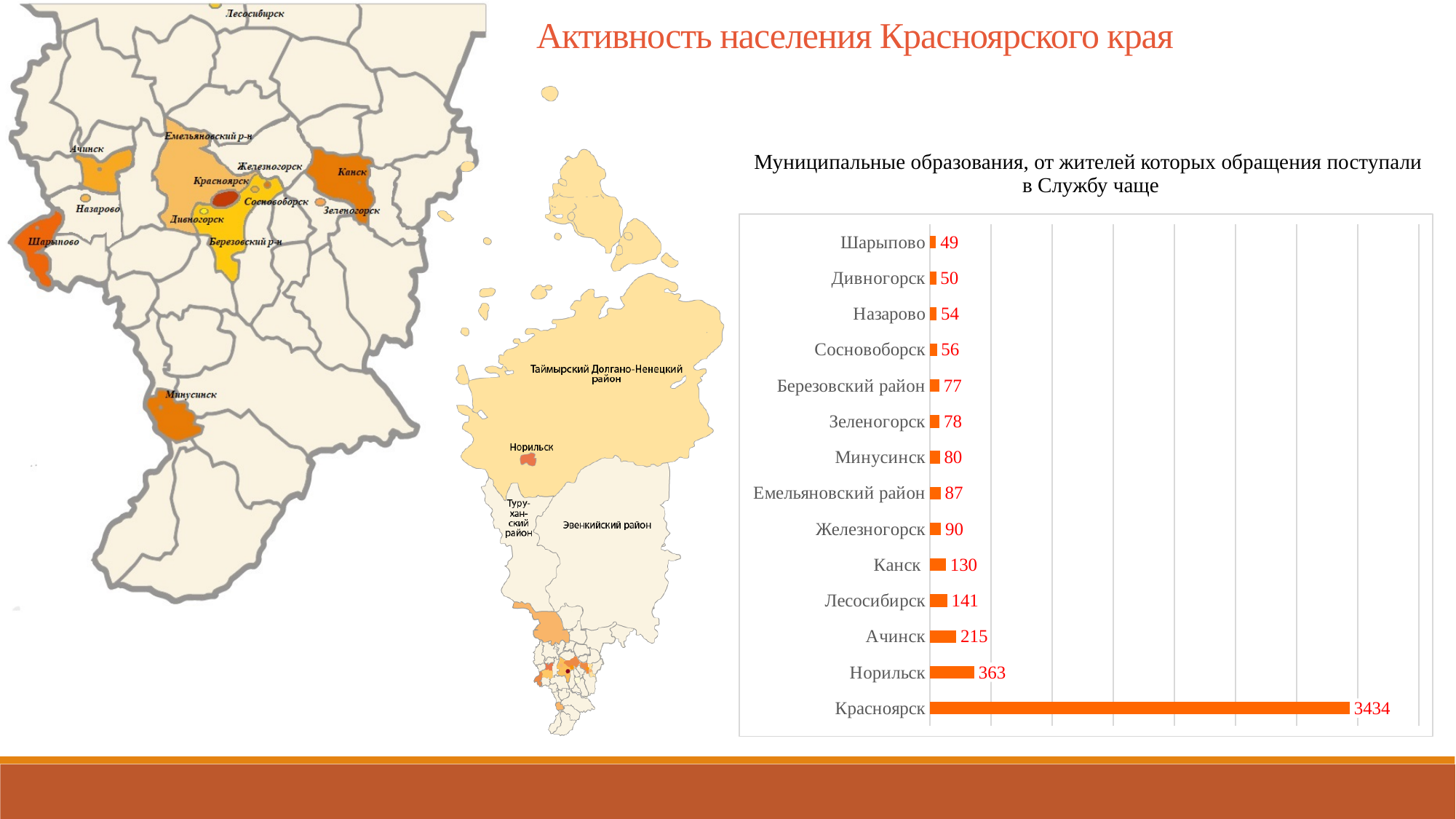
What is the title of the chart? Муниципальные образования, от жителей которых обращения поступали в Службу чаще What is the difference between the values for Красноярск and Норильск? 3071 What is the value for Норильск? 363 What kind of chart is shown on the slide? Bar chart How many municipalities are shown in the chart? 14 What is the value for Зеленогорск? 78 Which has a larger value, Канск or Лесосибирск? Лесосибирск What is the value for Красноярск? 3434 Which municipality has the lowest value? Шарыпово What is the difference between the values for Норильск and Ачинск? 148 Which municipality has the highest value? Красноярск What is the value for Емельяновский район? 87